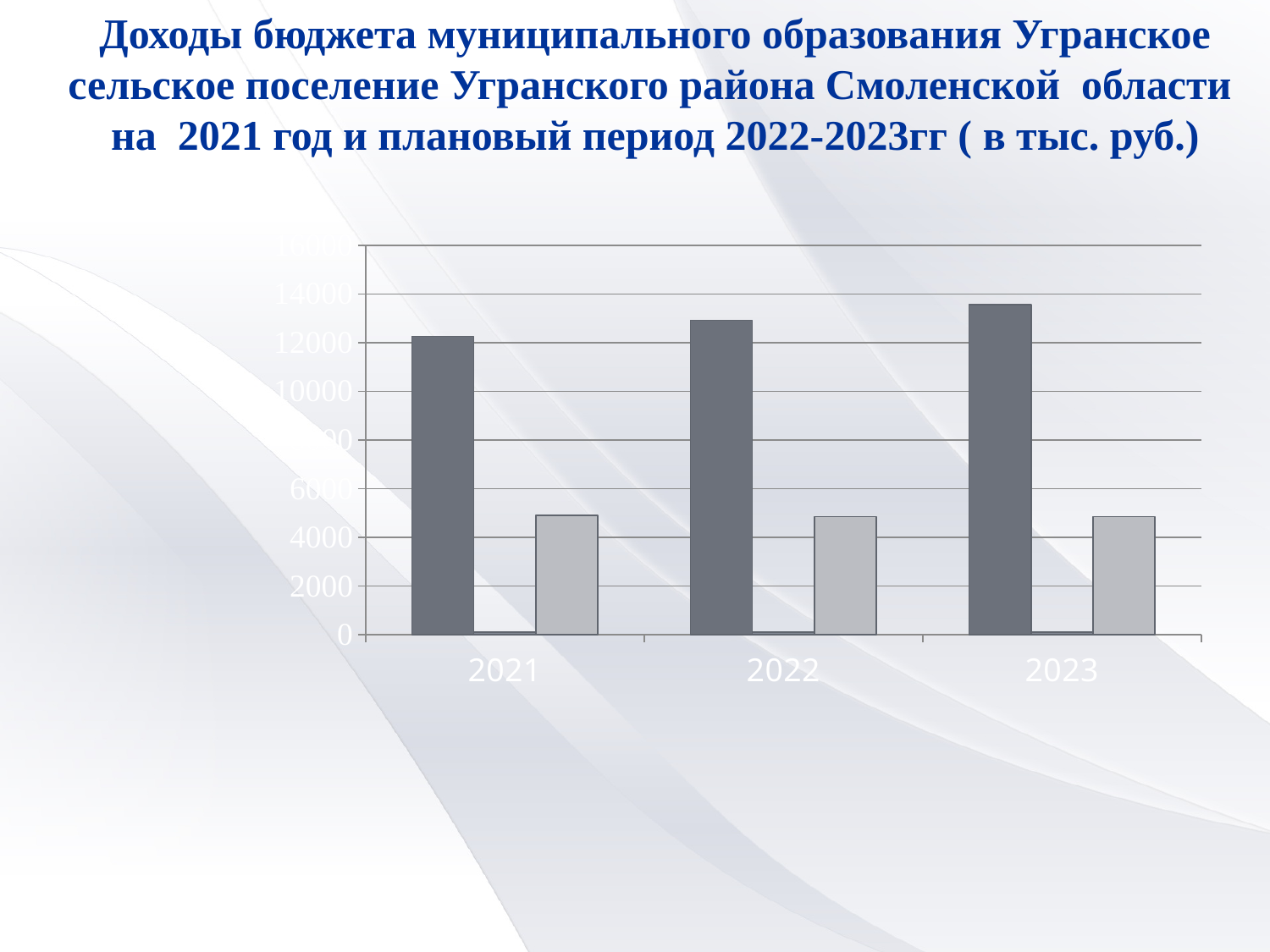
Is the value of the light gray bar for 2023 greater or less than 4000? greater For 2022, which is larger: the dark gray bar or the light gray bar? the dark gray bar Do the dark gray bars rise or fall from 2021 to 2023? rise How many years are shown on the x axis of the chart? 3 Is the value of the dark gray bar for 2022 greater or less than 12000? greater Which years are shown on the x axis of the chart? 2021, 2022, 2023 Is the value of the dark gray bar for 2021 greater or less than 10000? greater In which year is the dark gray bar the lowest? 2021 In which year is the dark gray bar the highest? 2023 What kind of chart is shown on the slide? bar chart